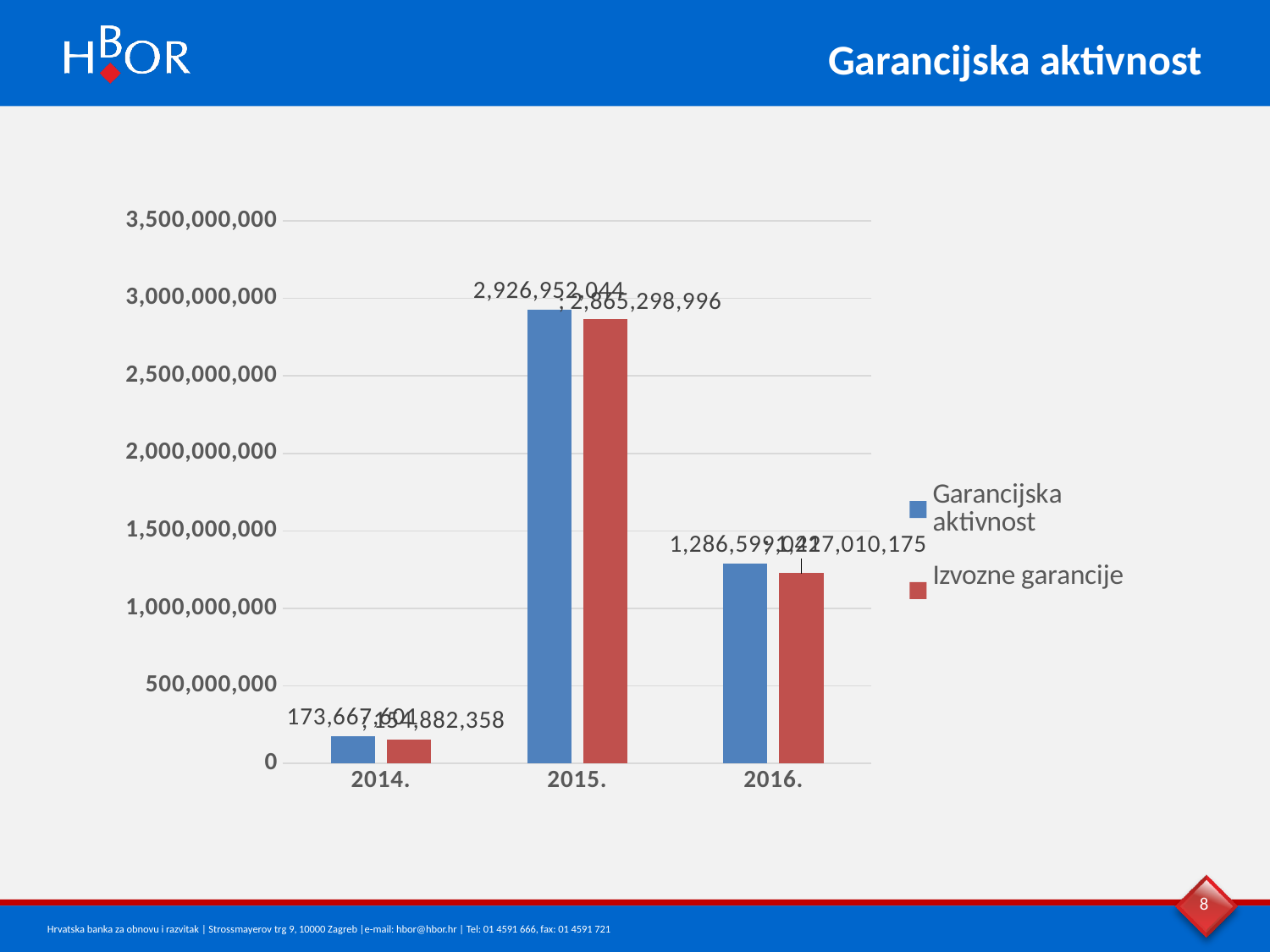
Which year has the highest value for Garancijska aktivnost? 2015. What is the value of Garancijska aktivnost for 2015.? 2,926,952,044 Which series is shown in red? Izvozne garancije Is the value of Izvozne garancije for 2014. greater or less than 500,000,000? less Is the value of Garancijska aktivnost for 2016. greater or less than 1,000,000,000? greater Which year has the lowest value for Izvozne garancije? 2014. What type of chart is shown on the slide? bar chart What is the difference between Garancijska aktivnost and Izvozne garancije in 2015.? 61,653,048 How many series does the legend list? 2 How many year categories are shown on the x axis? 3 In 2015., which is larger: Garancijska aktivnost or Izvozne garancije? Garancijska aktivnost What is the value of Izvozne garancije for 2015.? 2,865,298,996